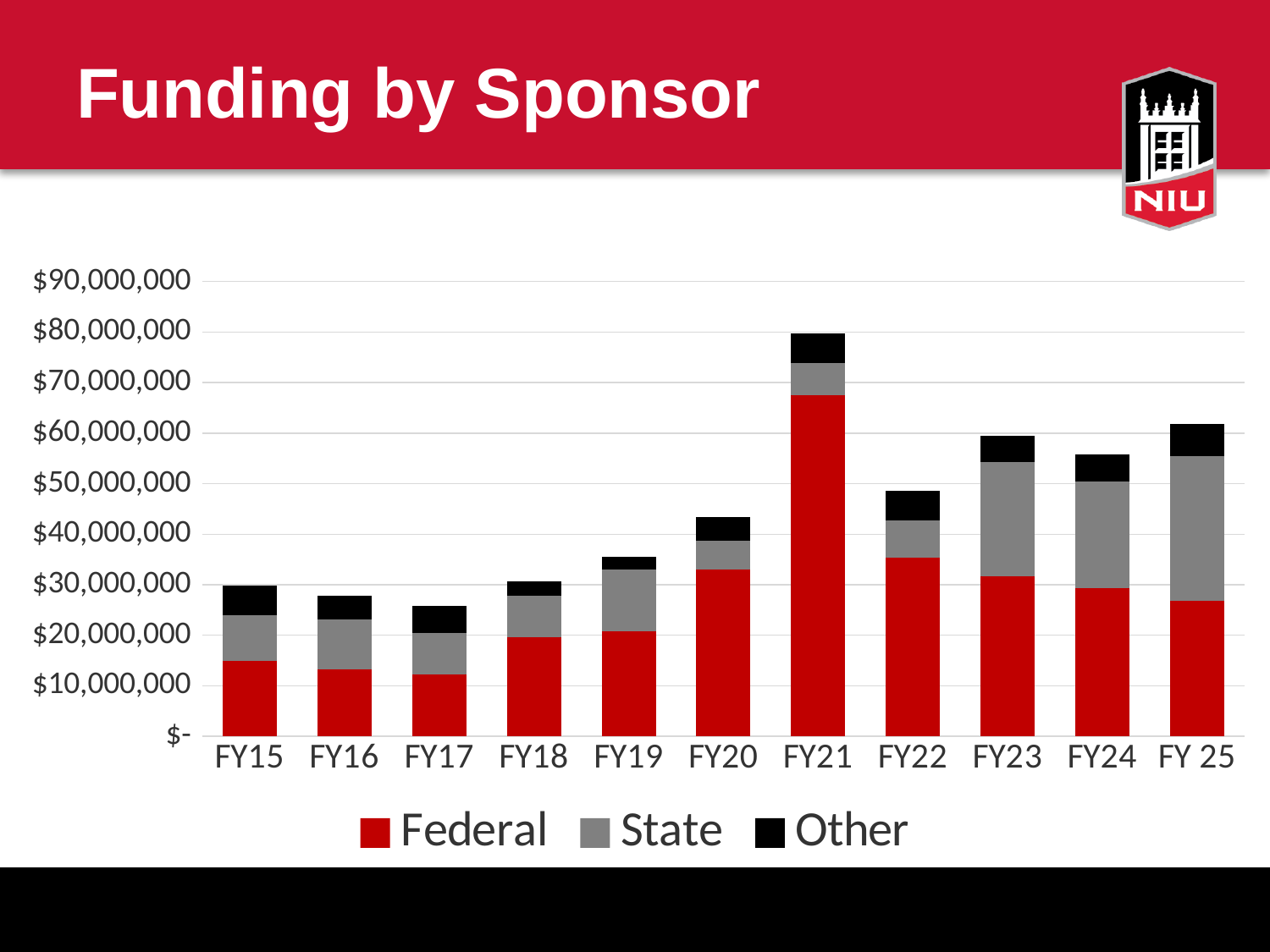
How many series does the legend list? 3 Does total funding rise or fall from FY17 to FY21? rise Which fiscal year has the highest total funding? FY21 What kind of chart is shown on the slide? Stacked bar chart Which has the larger total funding, FY23 or FY24? FY23 Which fiscal year has the lowest total funding? FY17 Which colour represents the Federal series in the legend? Red Is the Federal funding for FY20 greater or less than $30,000,000? greater Is the total funding for FY21 greater or less than $70,000,000? greater Is the Federal funding for FY 25 greater or less than $30,000,000? less How many fiscal years are shown on the x axis? 11